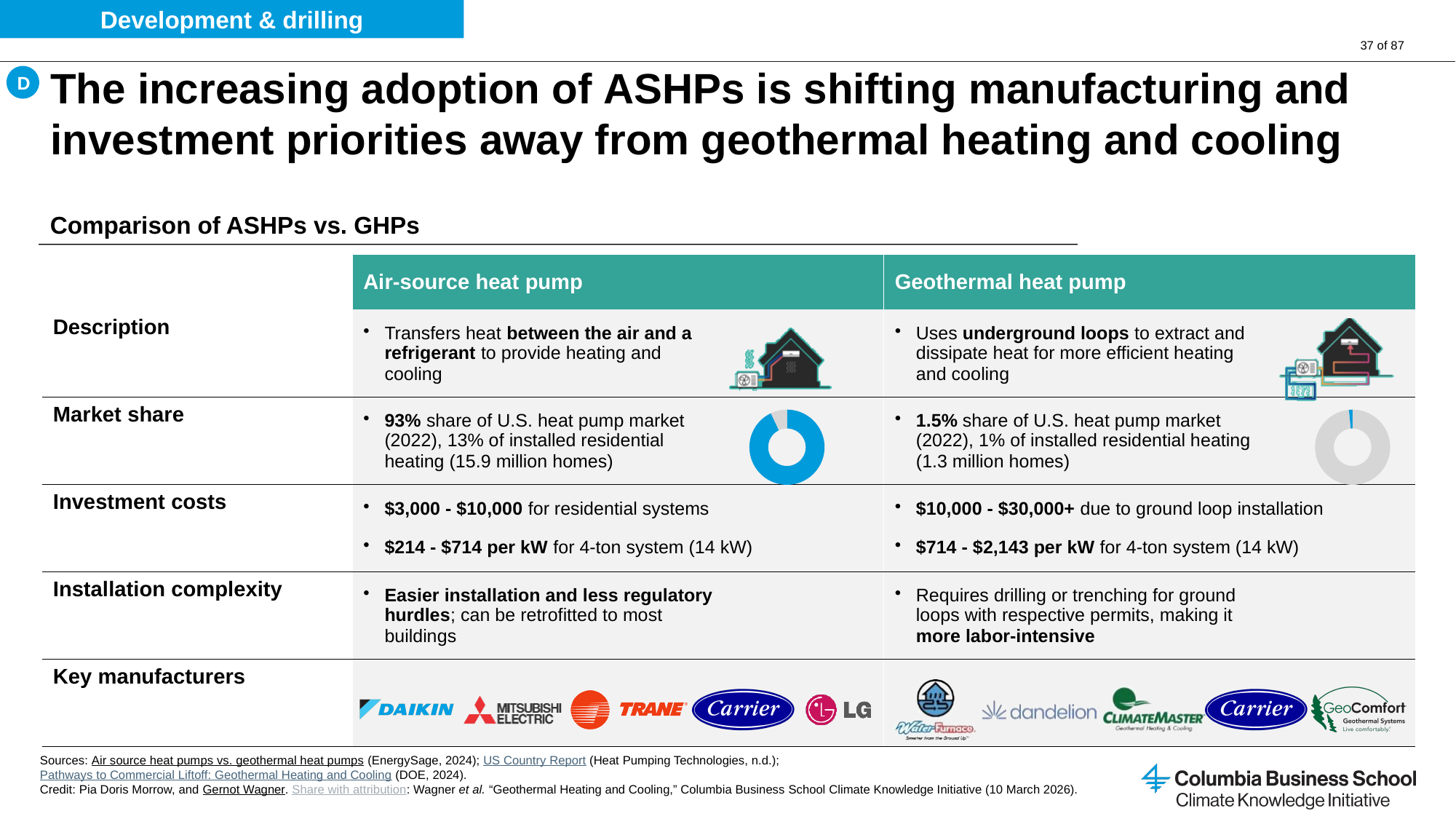
Is the share shown in the Geothermal heat pump donut chart greater or less than 10%? less According to the Market share row, for which year is the U.S. heat pump market share shown in the donut charts? 2022 What colour is the filled (highlighted) portion of the Air-source heat pump donut chart in the Market share row? Blue In the Market share row, what share of the U.S. heat pump market (2022) does the right donut chart for the Geothermal heat pump represent? 1.5% Is the share shown in the Air-source heat pump donut chart greater or less than 50%? greater In the Market share row, what share of the U.S. heat pump market (2022) does the left donut chart for the Air-source heat pump represent? 93% Which heat pump type's donut chart in the Market share row is almost entirely grey with only a thin blue sliver? Geothermal heat pump What is the difference between the U.S. heat pump market shares shown by the Air-source heat pump donut (93%) and the Geothermal heat pump donut (1.5%)? 91.5% What kind of chart is shown in the Market share row next to the Air-source heat pump text? Donut (pie) chart Comparing the two donut charts in the Market share row, which heat pump type has the larger share of the U.S. heat pump market? Air-source heat pump How many donut charts appear in the Market share row of the comparison table? 2